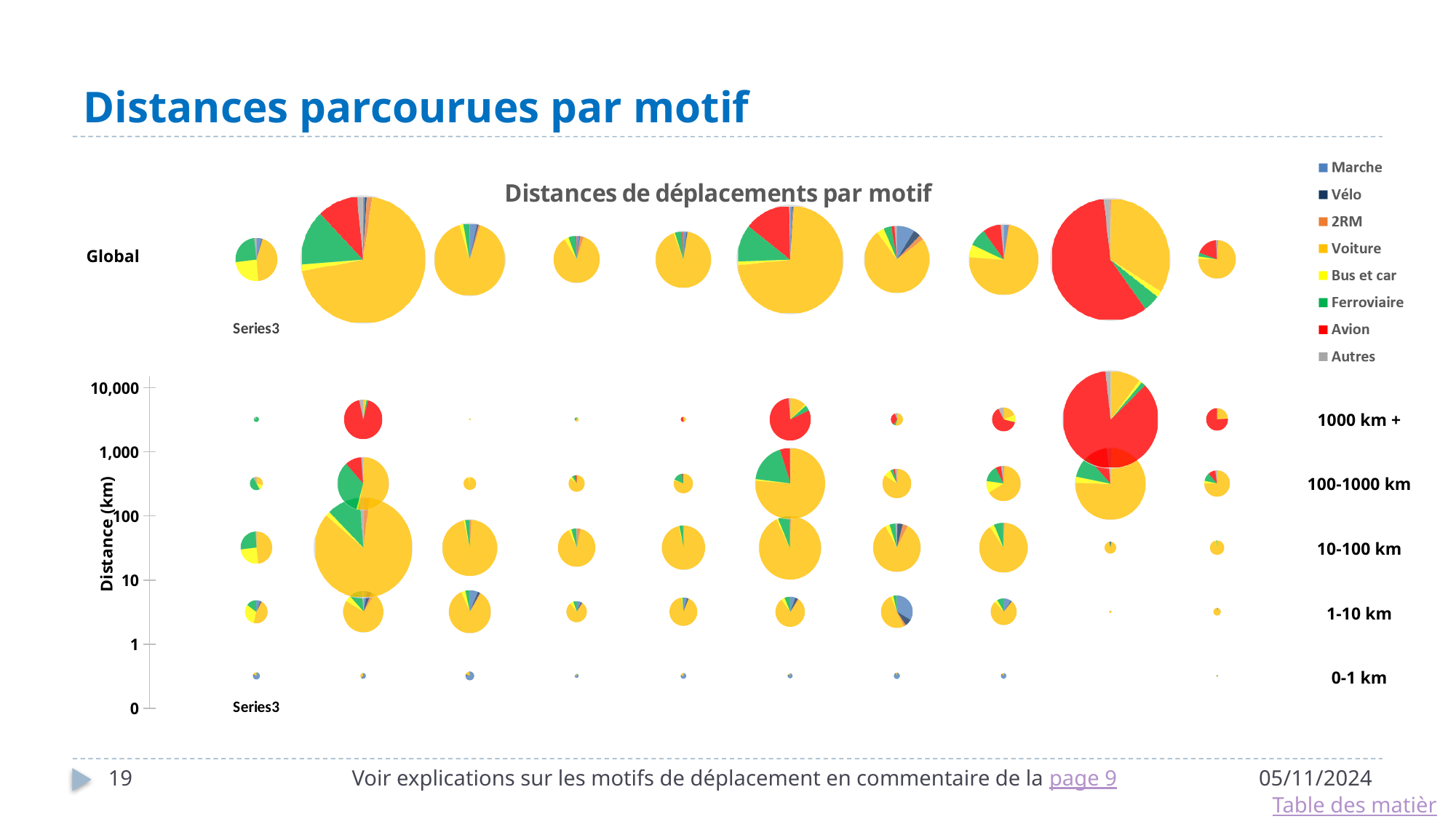
What is the highest tick value shown on the vertical axis of the lower chart? 10,000 What is the title of the chart? Distances de déplacements par motif How many series does the legend list? 8 Which distance band label appears at the top of the lower chart? 1000 km + What is the label of the vertical axis of the lower chart? Distance (km) What is the label of the top row of pie charts? Global What kind of chart is used to show the mode shares in each cell of the grid? Pie chart Which legend entry is shown in red? Avion Which distance band label appears at the bottom of the lower chart? 0-1 km How many distance bands are labelled on the right side of the lower chart? 5